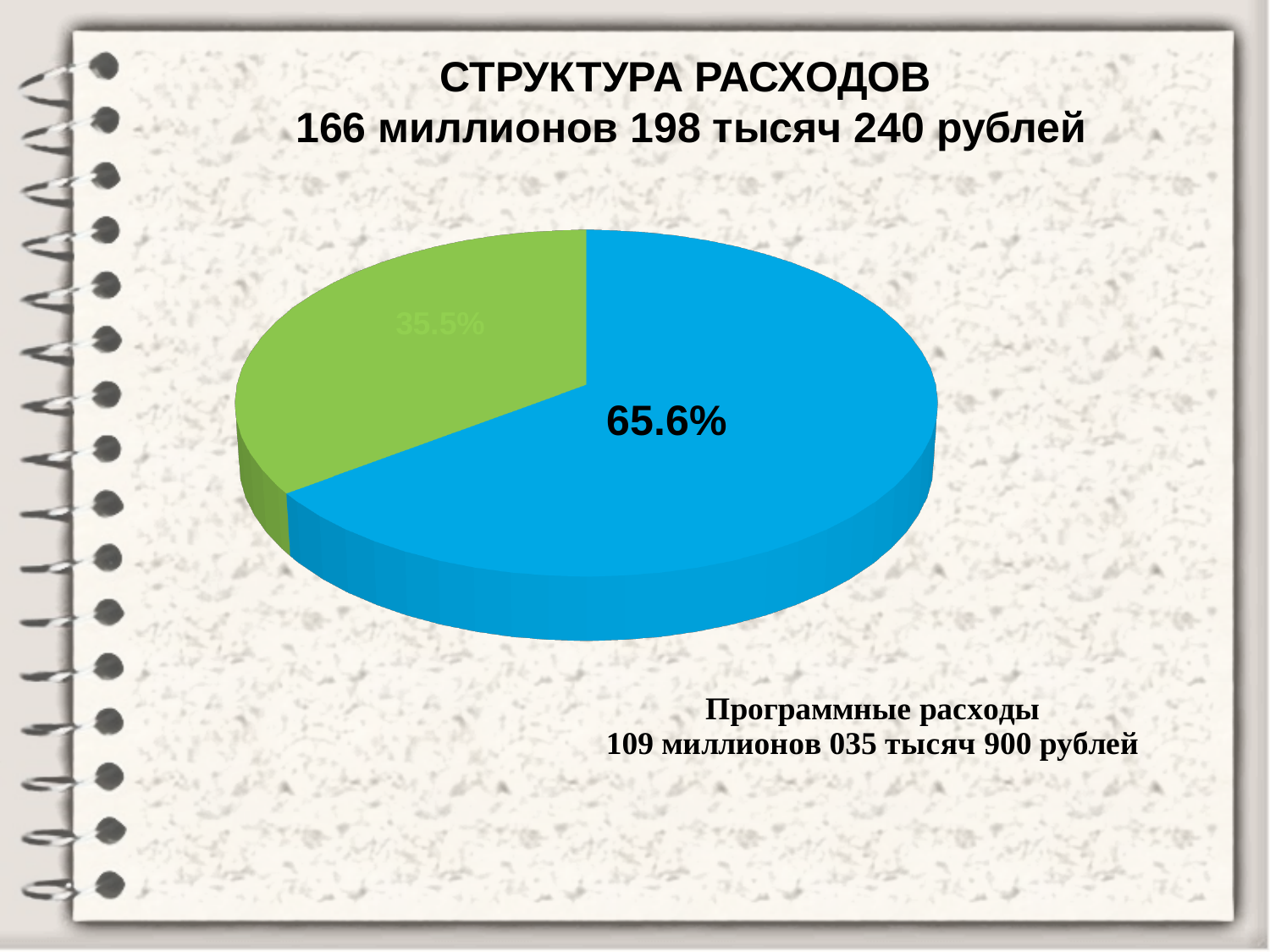
Which is larger, the blue slice or the green slice? The blue slice How many slices does the pie chart have? 2 Which slice of the pie chart is the smallest? The green slice (35.5%) What percentage is shown on the green slice of the pie chart? 35.5% What amount is given for Программные расходы on the slide? 109 миллионов 035 тысяч 900 рублей What total amount of expenses is stated in the chart title? 166 миллионов 198 тысяч 240 рублей Is the share of the blue slice greater or less than 50%? greater Which slice of the pie chart is the largest? The blue slice (65.6%) What percentage is shown on the blue slice of the pie chart? 65.6% What is the title of the chart? СТРУКТУРА РАСХОДОВ 166 миллионов 198 тысяч 240 рублей What kind of chart is shown on the slide? Pie chart By how many percentage points does the blue slice exceed the green slice? 30.1 percentage points